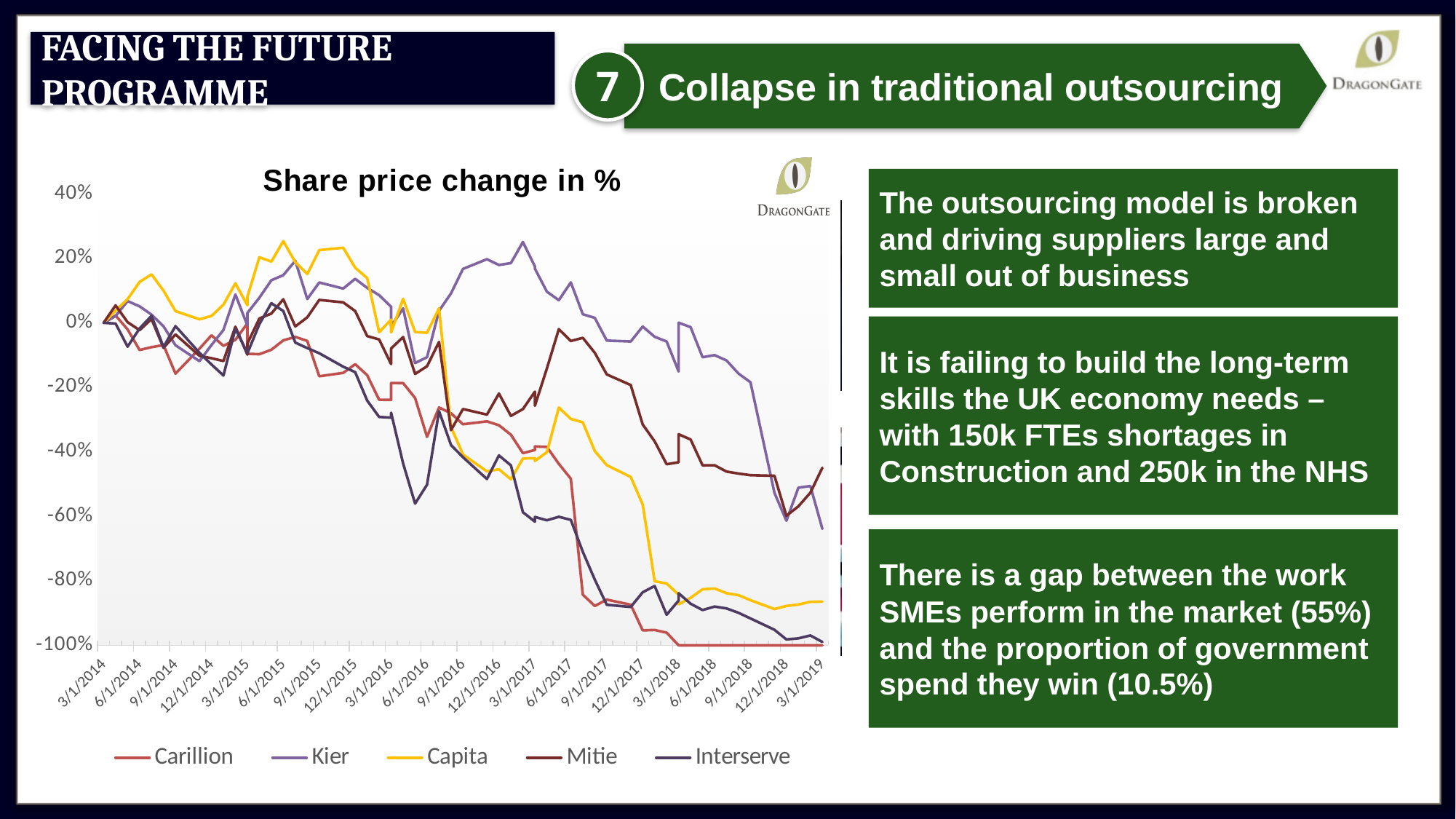
At 3/1/2019, which is higher: Kier or Interserve? Kier What type of chart is shown on the slide? line chart Is the value for Capita at 3/1/2019 greater or less than -80%? less Is the value for Mitie at 3/1/2019 greater or less than -60%? greater Is the value for Kier at 3/1/2019 greater or less than -80%? greater Which company's line is the highest at 3/1/2019? Mitie Does the Carillion line rise or fall overall from 3/1/2014 to 3/1/2019? fall At 3/1/2019, which is higher: Mitie or Capita? Mitie What is the title of the chart? Share price change in % How many series does the chart's legend list? 5